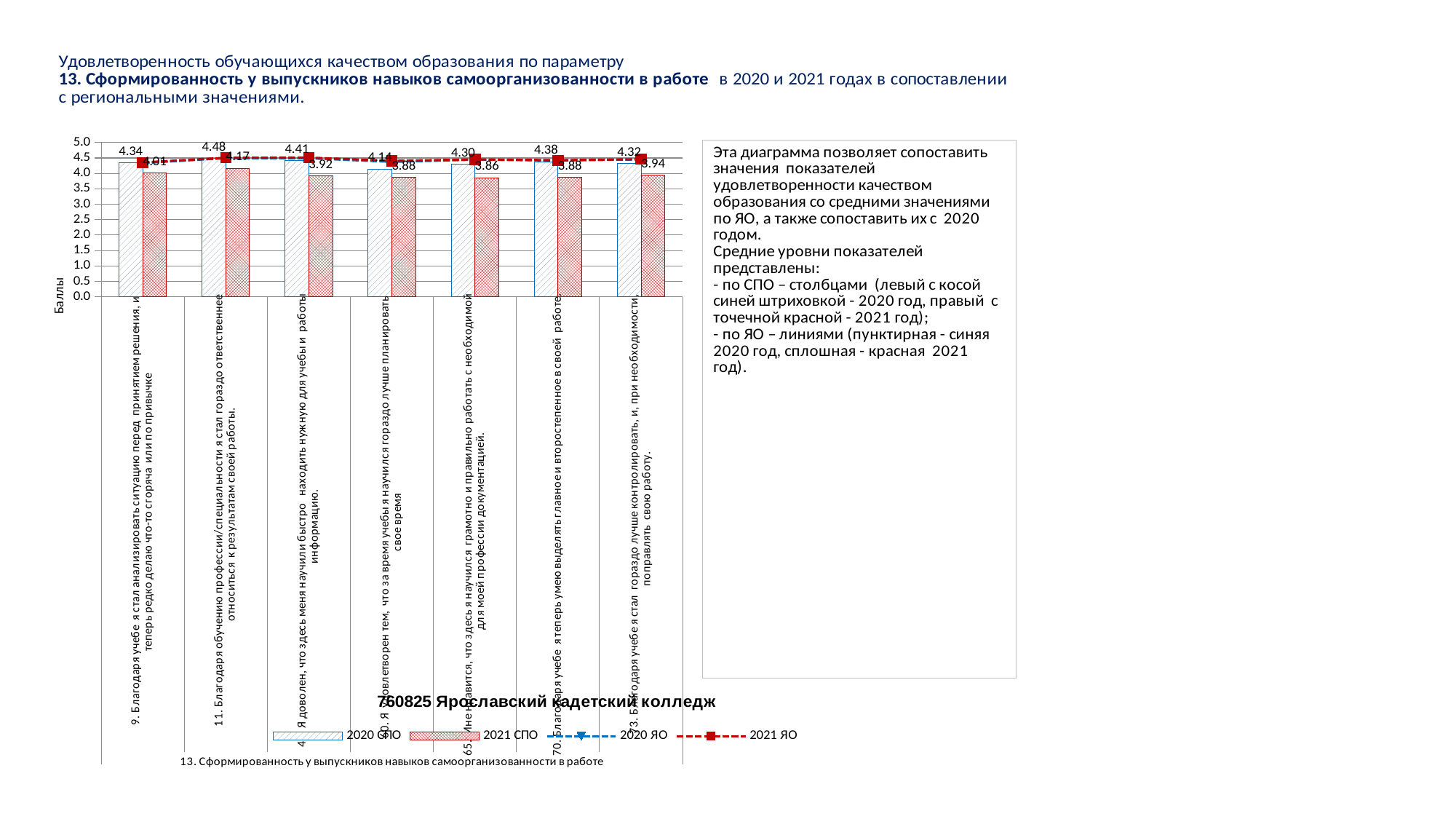
Which statement has the lowest 2021 СПО value? 65. Мне нравится, что здесь я научился грамотно и правильно работать с необходимой для моей профессии документацией What is the label of the vertical axis of the chart? Баллы What is the 2020 СПО value for the statement '11. Благодаря обучению профессии/специальности я стал гораздо ответственнее относиться к результатам своей работы'? 4.48 Is the 2021 СПО value for statement 70 (about distinguishing the main from the secondary in one's work) greater or less than 4.0? less What is the 2021 СПО value for the statement '65. Мне нравится, что здесь я научился грамотно и правильно работать с необходимой для моей профессии документацией'? 3.86 What is the difference between the 2020 СПО and 2021 СПО values for statement 11 (about being more responsible for the results of one's work)? 0.31 Which statement has the highest 2020 СПО value? 11. Благодаря обучению профессии/специальности я стал гораздо ответственнее относиться к результатам своей работы How many series does the chart legend list? 4 What kind of chart is shown on the slide? Combined bar and line chart How many statements (categories) are shown on the x axis of the chart? 7 What is the 2021 СПО value for the statement '73. Благодаря учебе я стал гораздо лучше контролировать, и, при необходимости, поправлять свою работу'? 3.94